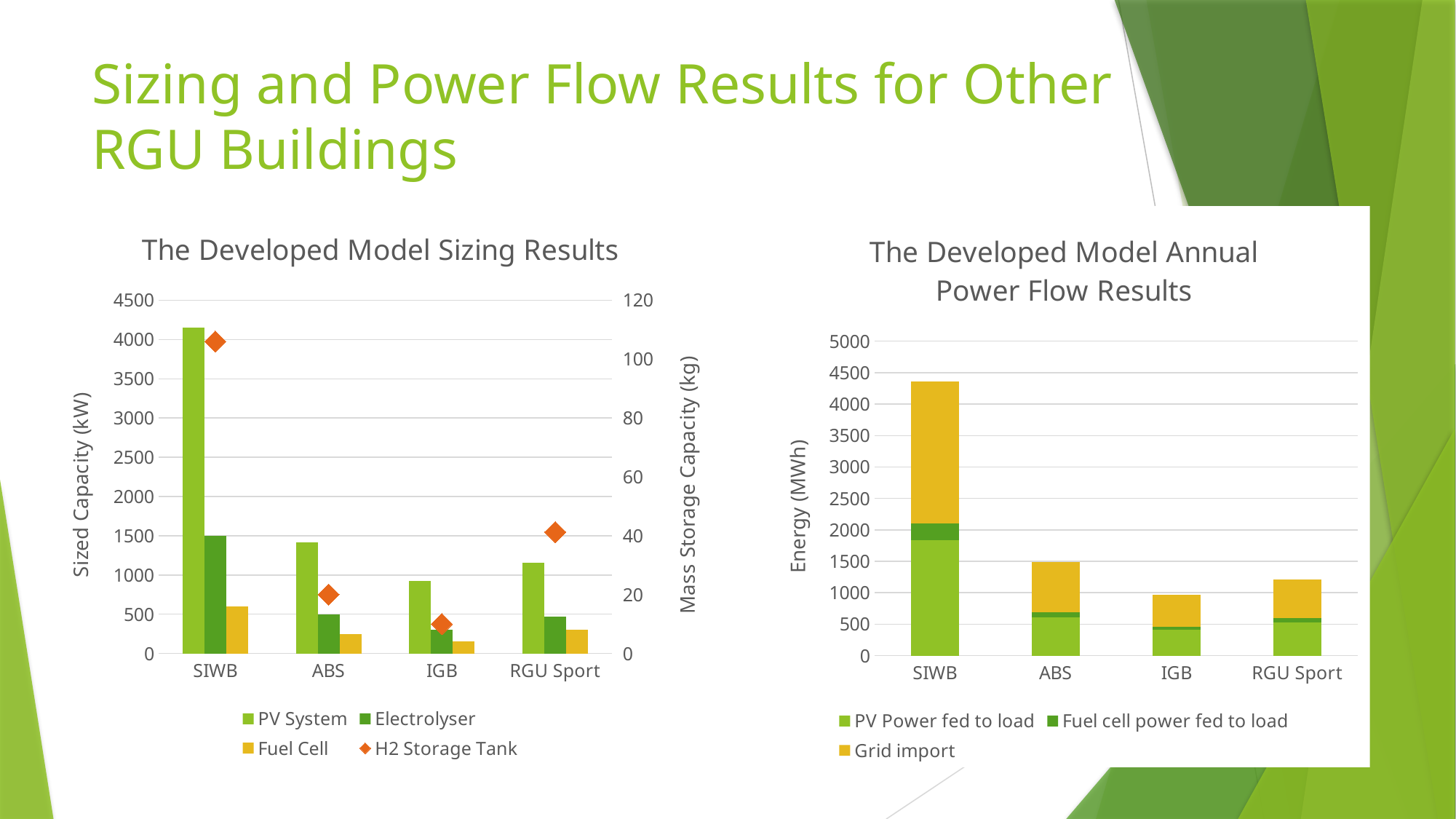
What kind of chart is the right chart, The Developed Model Annual Power Flow Results? Stacked bar chart On the left chart, The Developed Model Sizing Results, which is larger: the PV System capacity for ABS or for IGB? ABS On the left chart, The Developed Model Sizing Results, is the PV System value for ABS greater or less than 1500? less On the left chart, The Developed Model Sizing Results, which building has the highest PV System capacity? SIWB On the left chart, The Developed Model Sizing Results, is the H2 Storage Tank value for SIWB greater or less than 100 kg? greater On the left chart, The Developed Model Sizing Results, is the PV System value for SIWB greater or less than 4000? greater On the left chart, The Developed Model Sizing Results, how many series does the legend list? 4 On the right chart, The Developed Model Annual Power Flow Results, how many buildings are shown on the x axis? 4 On the left chart, The Developed Model Sizing Results, which building has the lowest PV System capacity? IGB On the right chart, The Developed Model Annual Power Flow Results, which building has the shortest stacked bar? IGB On the right chart, The Developed Model Annual Power Flow Results, which building has the tallest stacked bar? SIWB